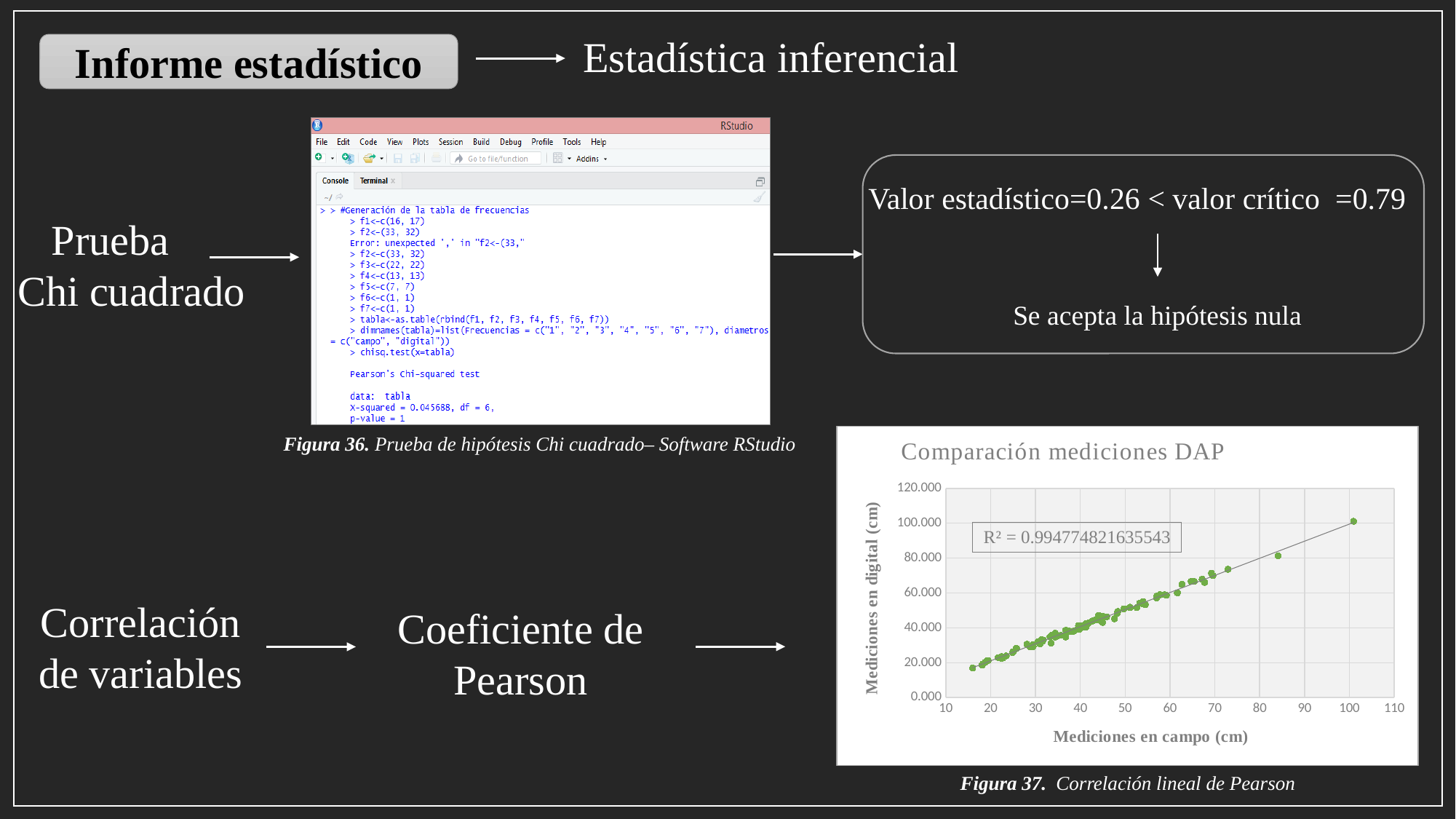
What is the title of the chart in Figura 37? Comparación mediciones DAP In the chart 'Comparación mediciones DAP', do the digital measurements rise or fall as the field measurements increase? rise In the chart 'Comparación mediciones DAP', which point has the highest digital measurement: the one at about 84 cm in the field or the one at about 101 cm in the field? the one at about 101 cm What kind of chart is shown in Figura 37? scatter chart In the chart 'Comparación mediciones DAP', is the digital measurement for the rightmost point (around 100 cm in the field) greater or less than 80.000? greater In the chart 'Comparación mediciones DAP', is the digital measurement for the leftmost point (around 16 cm in the field) greater or less than 20.000? less In the chart 'Comparación mediciones DAP', is the digital measurement for the point at about 84 cm in the field greater or less than 100.000? less What is the label of the x axis in the chart 'Comparación mediciones DAP'? Mediciones en campo (cm) What is the highest tick value shown on the y axis of the chart 'Comparación mediciones DAP'? 120.000 What is the R² value printed on the chart 'Comparación mediciones DAP'? R² = 0.994774821635543